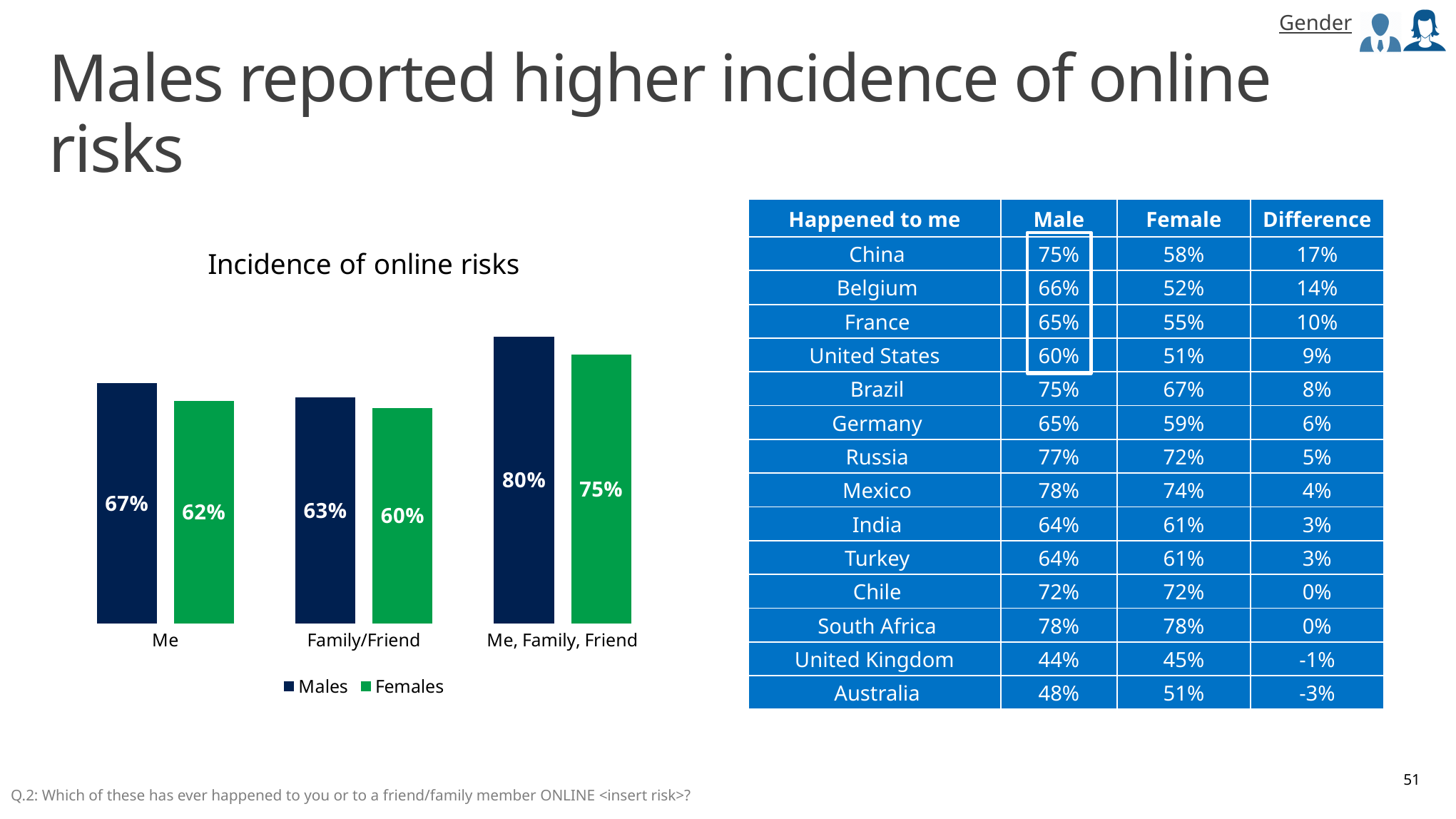
Which category has the lowest value for Males? Family/Friend What is the value for Males in the Me, Family, Friend category? 80% What is the difference between Males and Females in the Me category? 5% What is the value for Females in the Family/Friend category? 60% What kind of chart is shown on the slide? Bar chart How many series does the chart legend list? 2 How many categories are shown on the x axis of the chart? 3 Which is larger, the Males value for Me or the Males value for Family/Friend? Me Which category has the highest value for Females? Me, Family, Friend What is the title of the chart? Incidence of online risks What is the value for Males in the Me category? 67% What is the difference between Males and Females in the Me, Family, Friend category? 5%